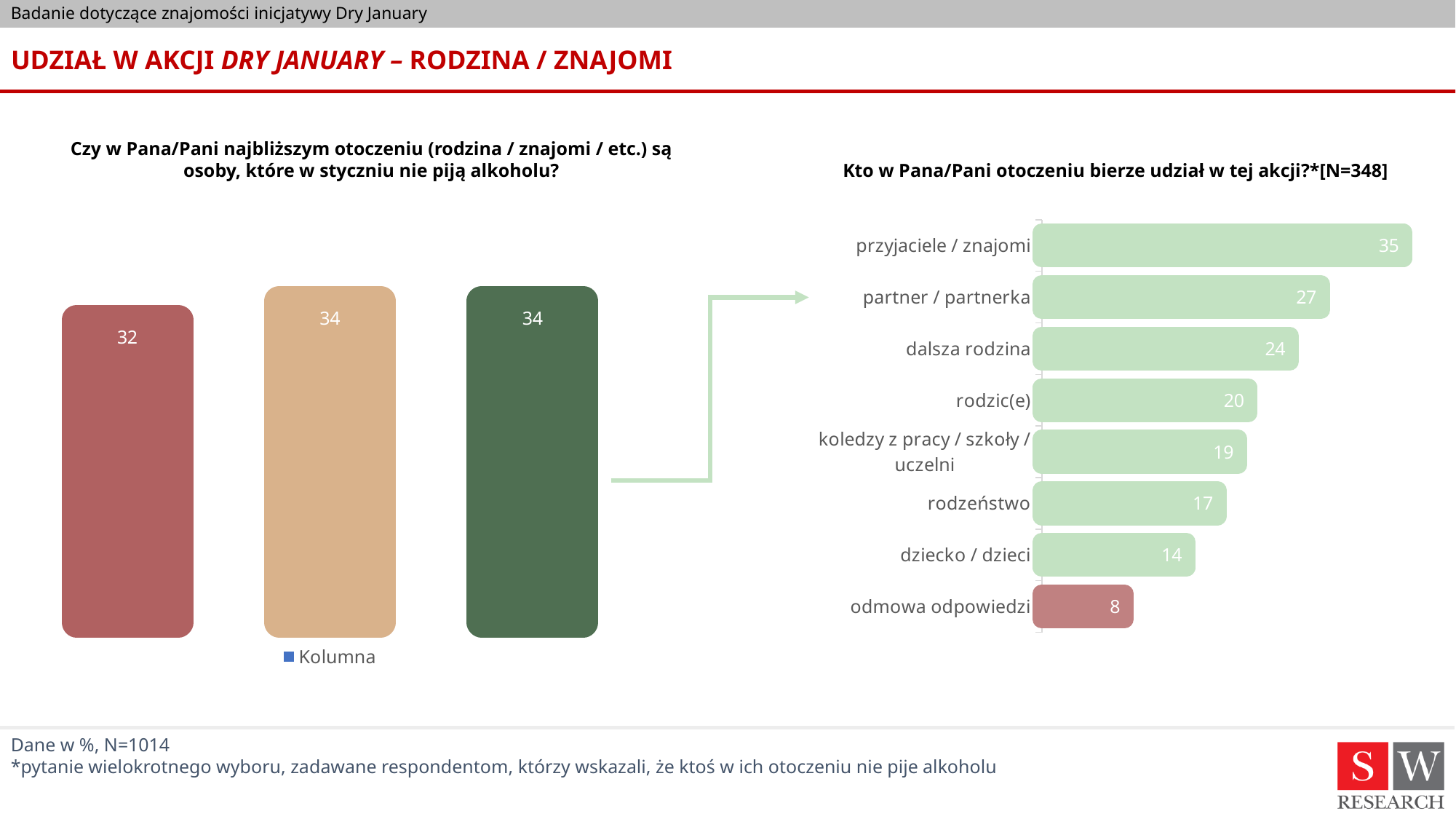
What kind of chart is the right chart 'Kto w Pana/Pani otoczeniu bierze udział w tej akcji?'? Horizontal bar chart In the right chart 'Kto w Pana/Pani otoczeniu bierze udział w tej akcji?', how many categories are shown? 8 In the right chart 'Kto w Pana/Pani otoczeniu bierze udział w tej akcji?', what is the value for 'partner / partnerka'? 27 In the right chart 'Kto w Pana/Pani otoczeniu bierze udział w tej akcji?', which category has the lowest value? odmowa odpowiedzi In the left chart 'Czy w Pana/Pani najbliższym otoczeniu ... są osoby, które w styczniu nie piją alkoholu?', what is the lowest value shown on a bar? 32 In the right chart 'Kto w Pana/Pani otoczeniu bierze udział w tej akcji?', which is larger: 'dalsza rodzina' or 'rodzic(e)'? dalsza rodzina In the left chart 'Czy w Pana/Pani najbliższym otoczeniu ... są osoby, które w styczniu nie piją alkoholu?', how many bars are shown? 3 In the right chart 'Kto w Pana/Pani otoczeniu bierze udział w tej akcji?', what is the difference between 'przyjaciele / znajomi' and 'dziecko / dzieci'? 21 What entry does the legend of the left chart show? Kolumna In the right chart 'Kto w Pana/Pani otoczeniu bierze udział w tej akcji?', what is the value for 'koledzy z pracy / szkoły / uczelni'? 19 In the right chart 'Kto w Pana/Pani otoczeniu bierze udział w tej akcji?', which category has the highest value? przyjaciele / znajomi In the right chart 'Kto w Pana/Pani otoczeniu bierze udział w tej akcji?', what is the value for 'rodzeństwo'? 17